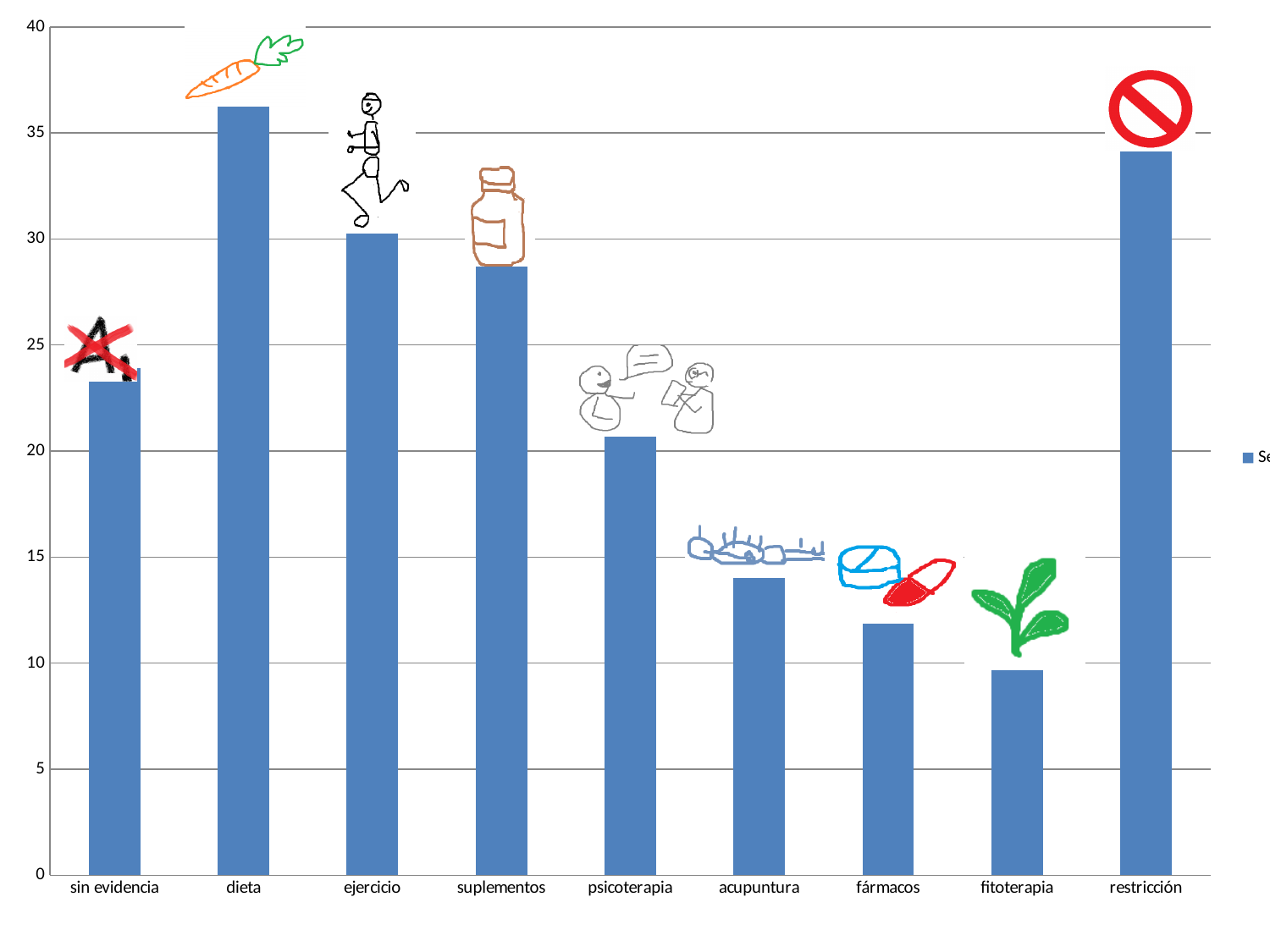
Is the value for suplementos greater or less than 30? less Is the value for fitoterapia greater or less than 10? less Is the value for restricción greater or less than 35? less Which category has the lowest bar? fitoterapia How many categories are shown on the x axis? 9 Which is larger, the value for acupuntura or the value for fármacos? acupuntura What kind of chart is shown on the slide? bar chart From dieta to fitoterapia, do the bar values rise or fall along the x axis? fall Which is larger, the value for psicoterapia or the value for sin evidencia? sin evidencia Which category has the highest bar? dieta